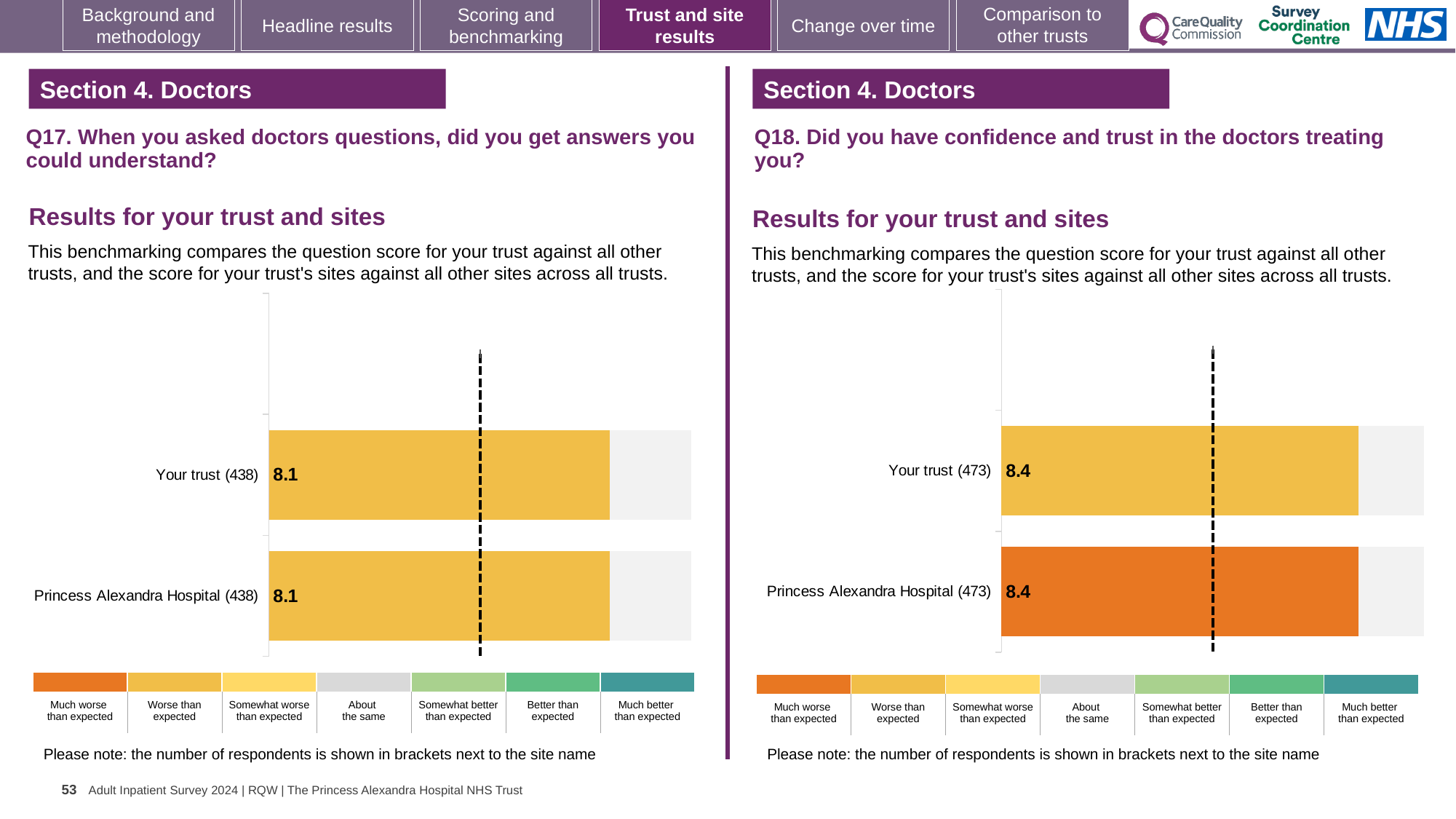
How many bars are plotted on the Q18 chart (right)? 2 On the Q17 chart (left), what is the score for Princess Alexandra Hospital? 8.1 On the Q17 chart (left), which benchmark category does the colour of the Your trust bar correspond to in the key? Worse than expected On the Q17 chart (left), what is the difference between the score for Your trust and the score for Princess Alexandra Hospital? 0 Is the score for Your trust on the Q18 chart (right) larger than the score for Your trust on the Q17 chart (left)? Yes On the Q18 chart (right), what is the score for Princess Alexandra Hospital? 8.4 On the Q17 chart (left), what is the score for Your trust? 8.1 On the Q18 chart (right), how many respondents are shown in brackets for Your trust? 473 On the Q17 chart (left), how many respondents are shown in brackets for Princess Alexandra Hospital? 438 On the Q18 chart (right), what is the score for Your trust? 8.4 On the Q18 chart (right), which benchmark category does the colour of the Princess Alexandra Hospital bar correspond to in the key? Much worse than expected What kind of chart is used on the Q17 chart (left)? Bar chart